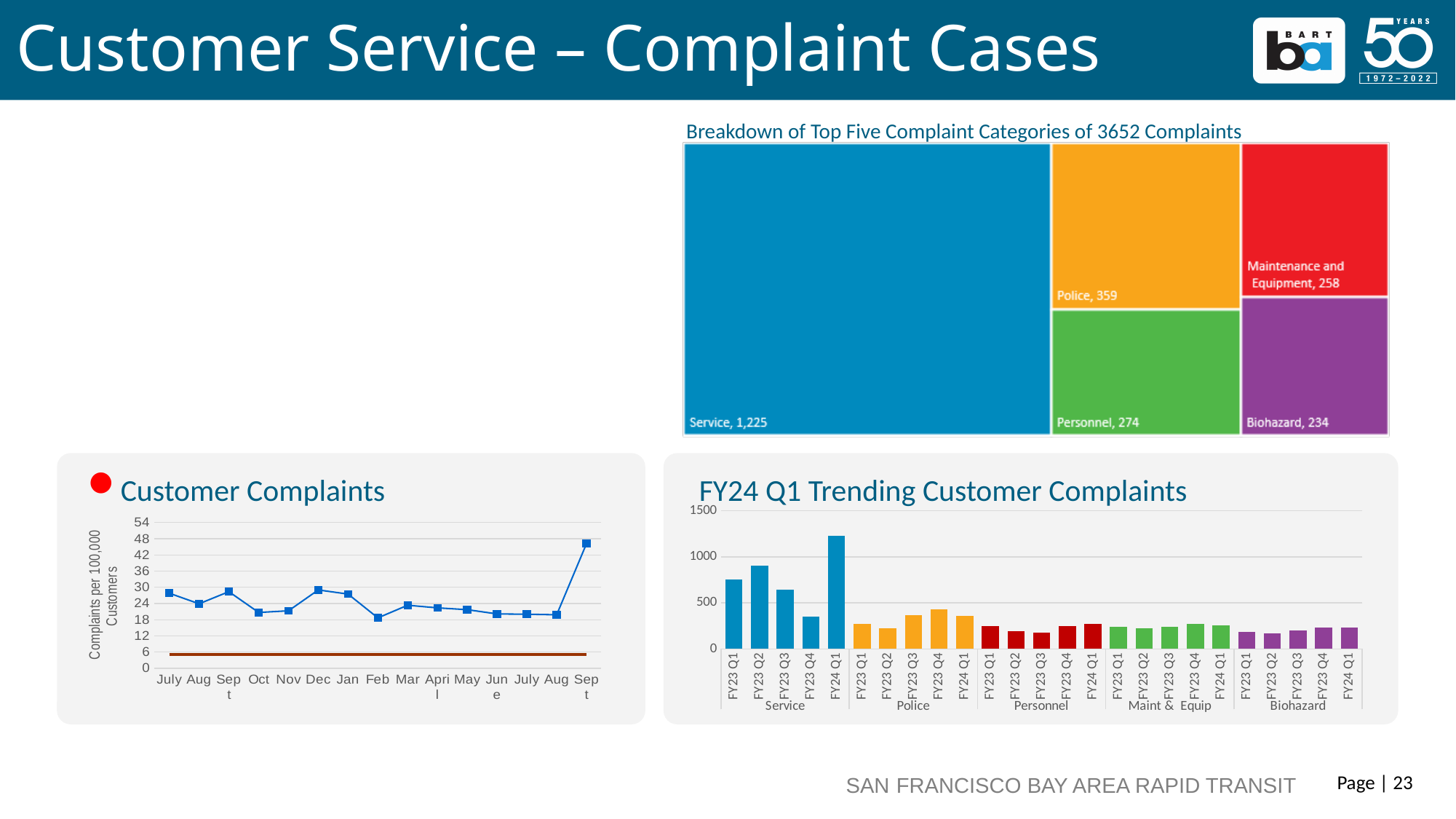
In the treemap 'Breakdown of Top Five Complaint Categories of 3652 Complaints', which category has the fewest complaints? Biohazard In the treemap 'Breakdown of Top Five Complaint Categories of 3652 Complaints', how many categories are shown? 5 In the 'FY24 Q1 Trending Customer Complaints' chart, is the value for Service FY24 Q1 greater or less than 1000? greater In the 'Customer Complaints' line chart, is the value for Feb greater or less than 24? less In the 'Customer Complaints' line chart, is the value for the final Sept point greater or less than 42? greater What type of chart is 'FY24 Q1 Trending Customer Complaints'? bar chart In the treemap 'Breakdown of Top Five Complaint Categories of 3652 Complaints', which has more complaints: Maintenance and Equipment or Biohazard? Maintenance and Equipment In the 'Customer Complaints' line chart, which month has the highest complaints per 100,000 customers? Sept (the last point) In the treemap 'Breakdown of Top Five Complaint Categories of 3652 Complaints', what is the difference between the Police and Personnel complaint counts? 85 In the treemap 'Breakdown of Top Five Complaint Categories of 3652 Complaints', how many complaints are in the Service category? 1,225 In the 'FY24 Q1 Trending Customer Complaints' chart, which bar is the tallest? Service FY24 Q1 In the treemap 'Breakdown of Top Five Complaint Categories of 3652 Complaints', how many complaints are in the Police category? 359